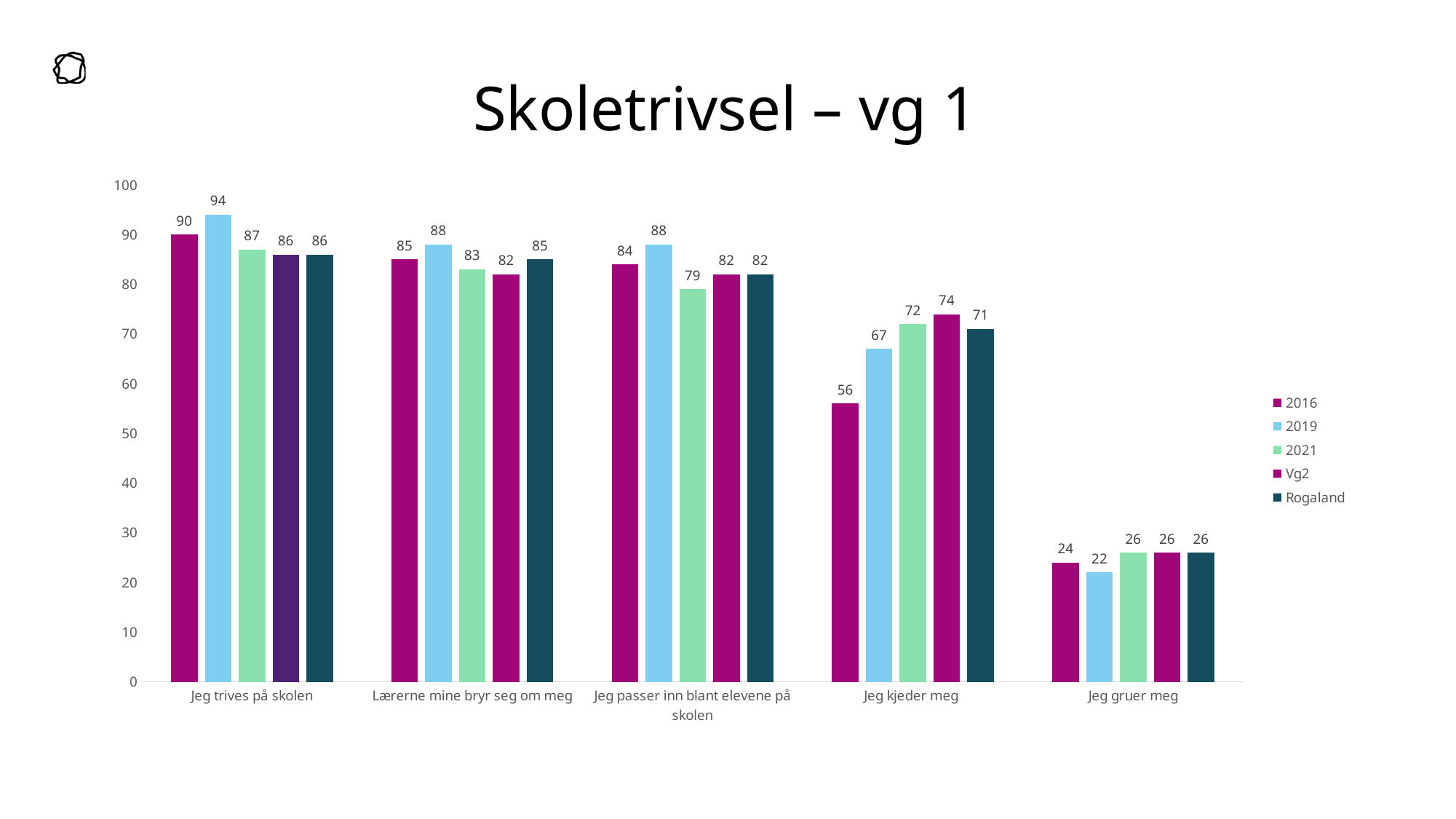
What is the value for 2016 in the category "Jeg kjeder meg"? 56 Which is larger in the category "Jeg trives på skolen": the value for 2016 or the value for 2021? 2016 What is the value for Rogaland in the category "Lærerne mine bryr seg om meg"? 85 What is the value for 2021 in the category "Jeg passer inn blant elevene på skolen"? 79 How many series does the legend list? 5 Which series has the lowest value in the category "Jeg gruer meg"? 2019 What is the difference between the 2019 and 2016 values in the category "Jeg kjeder meg"? 11 How many categories are shown on the x axis? 5 What kind of chart is shown on the slide? Bar chart Which series has the highest value in the category "Jeg kjeder meg"? Vg2 What is the title of the slide? Skoletrivsel – vg 1 What is the value for 2019 in the category "Jeg trives på skolen"? 94